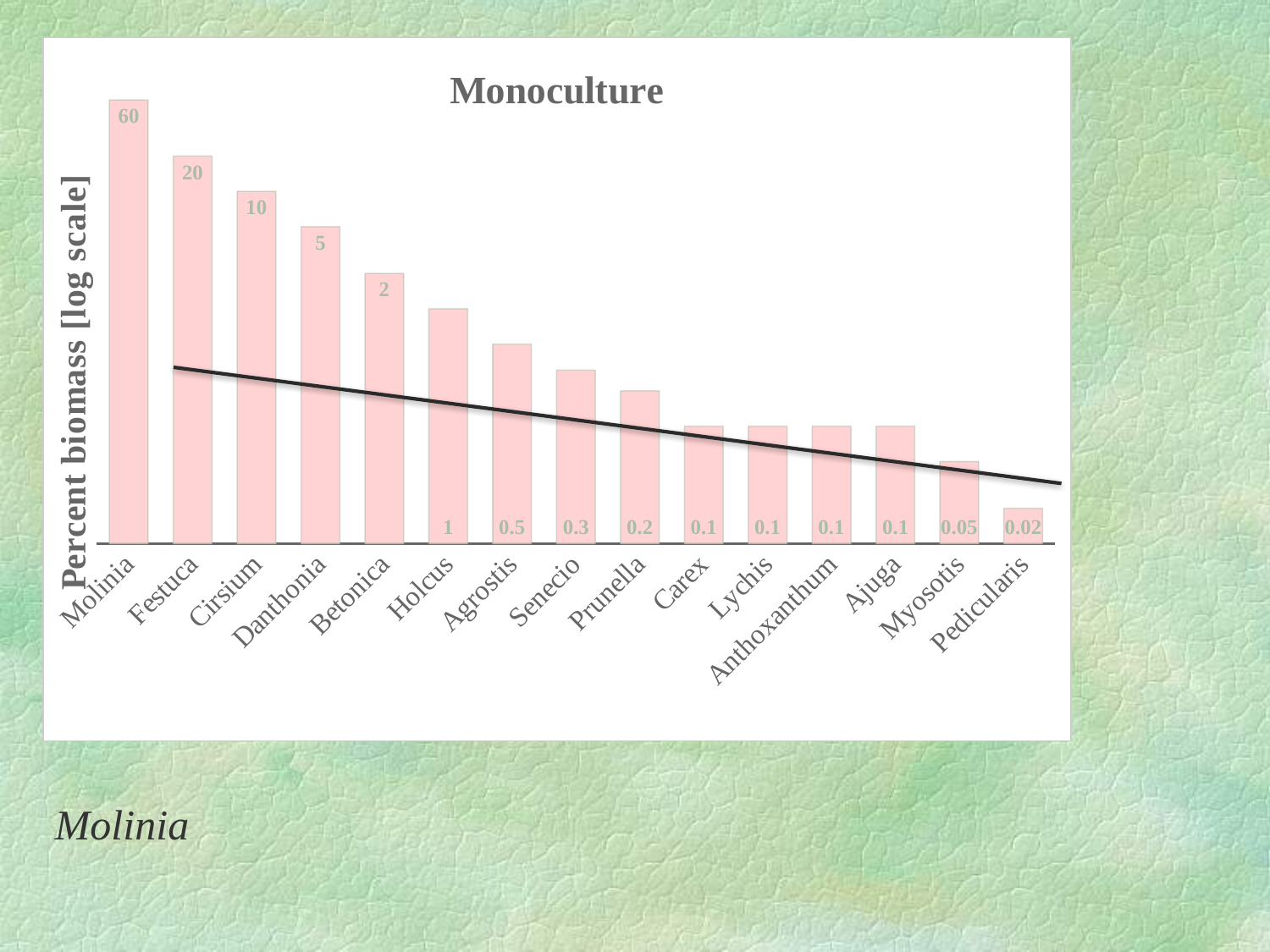
What is the difference between the values for Festuca and Cirsium? 10 Do the values rise or fall from left to right along the x axis? Fall Which is larger, the value for Betonica or the value for Prunella? Betonica Which category has the lowest value? Pedicularis What is the value for Senecio? 0.3 What is the value for Molinia? 60 How many categories are shown on the x axis? 15 What is the difference between the values for Holcus and Agrostis? 0.5 Which category has the highest value? Molinia What kind of chart is this? Bar chart What is the value for Danthonia? 5 What is the value for Pedicularis? 0.02